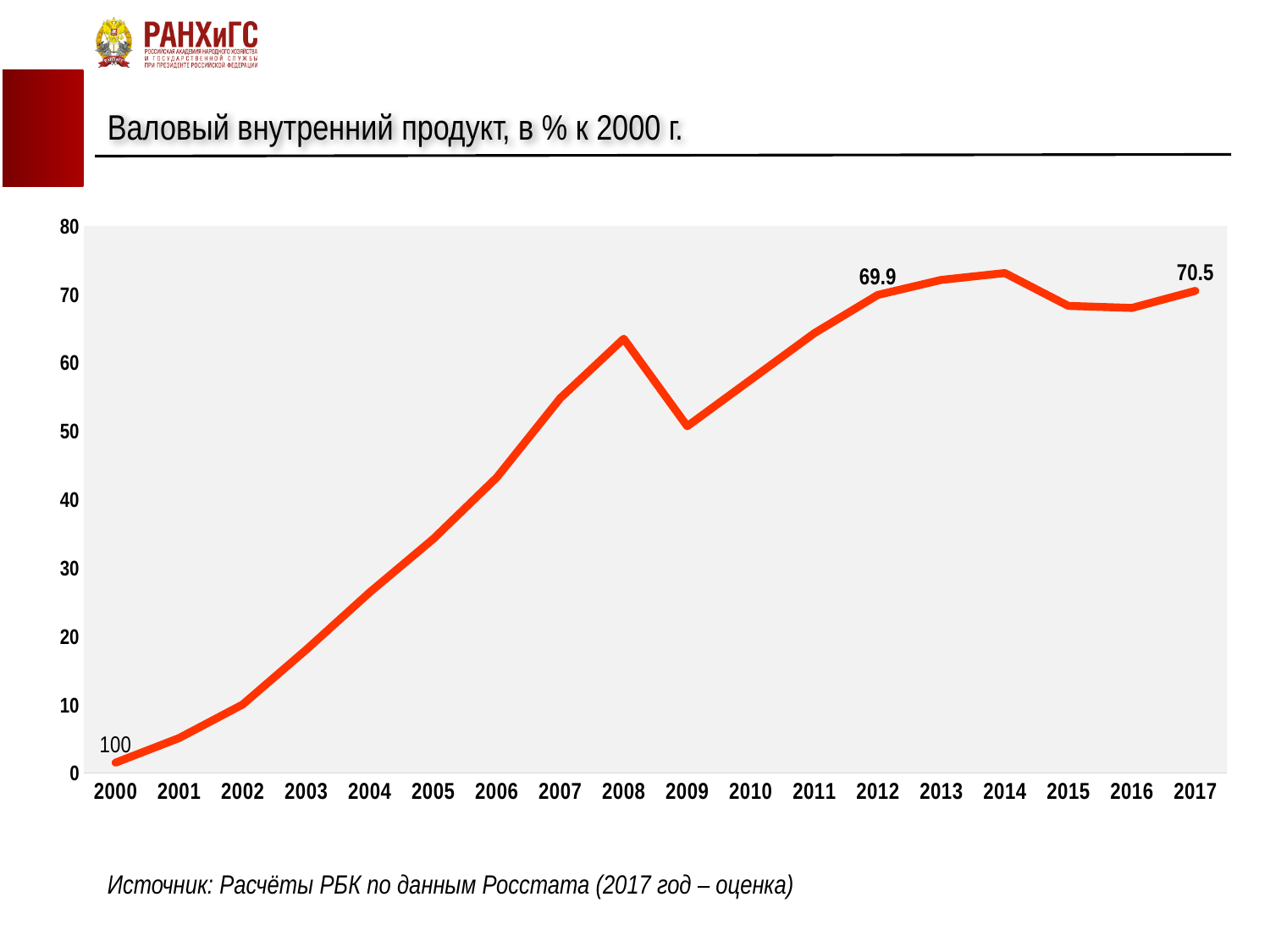
Which year has the lowest value on the chart? 2000 Which year has the higher labelled value, 2012 or 2017? 2017 What value is labelled for 2017? 70.5 Which year has the highest value on the chart? 2014 Is the value for 2003 greater or less than 20? less How many years are shown on the x axis? 18 What is the title of the chart? Валовый внутренний продукт, в % к 2000 г. Is the value for 2008 greater or less than 60? greater What kind of chart is shown on the slide? line chart What is the difference between the labelled values for 2017 and 2012? 0.6 What value is labelled for 2012? 69.9 Which year has the larger value, 2008 or 2009? 2008